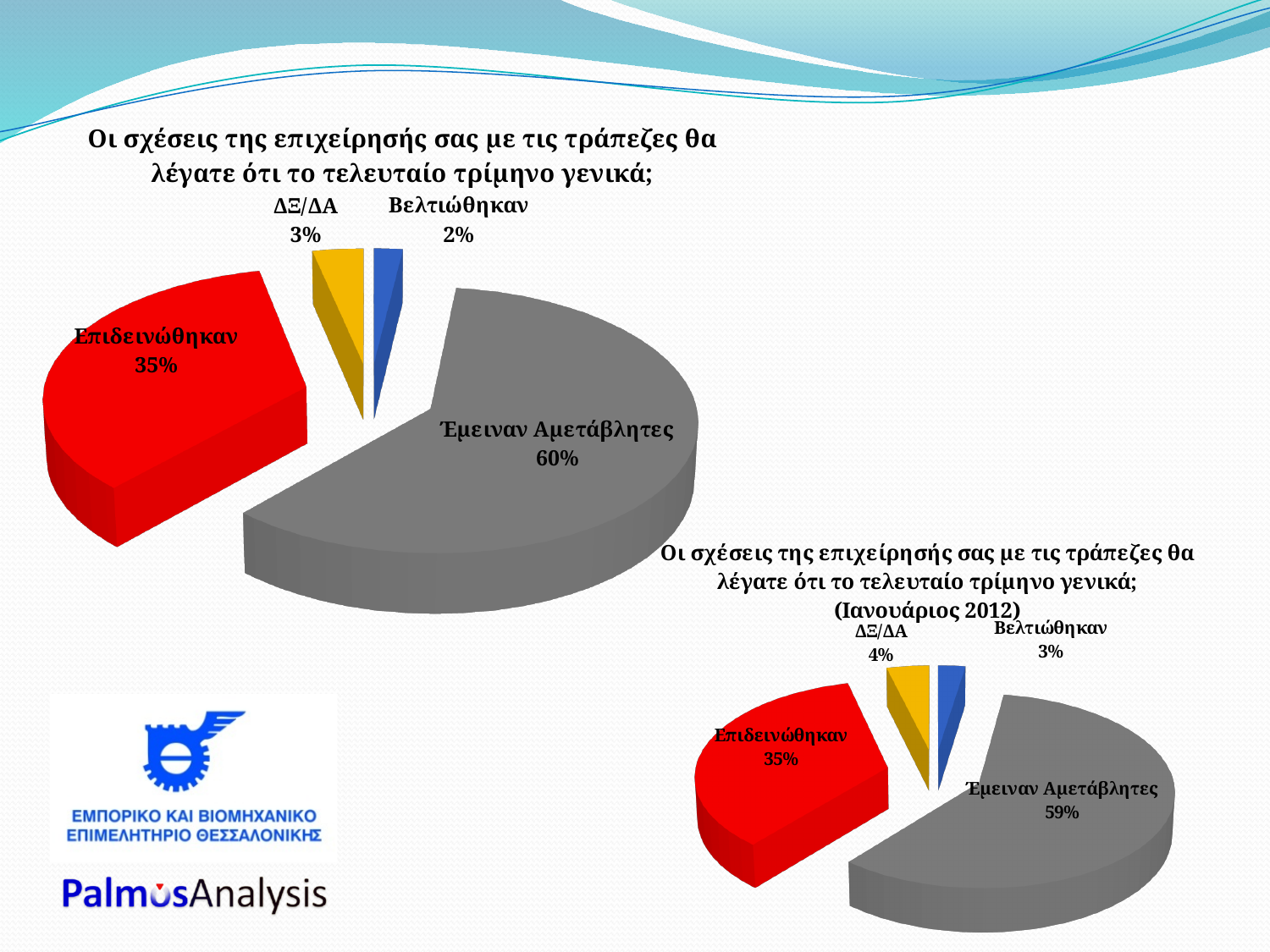
In the bottom-right pie chart (Ιανουάριος 2012), which category has the smallest share? Βελτιώθηκαν In the top-left pie chart, what percentage is shown for Βελτιώθηκαν? 2% In the bottom-right pie chart (Ιανουάριος 2012), which is larger: Επιδεινώθηκαν or ΔΞ/ΔΑ? Επιδεινώθηκαν In the top-left pie chart, what percentage is shown for Έμειναν Αμετάβλητες? 60% In the bottom-right pie chart (Ιανουάριος 2012), what percentage is shown for Έμειναν Αμετάβλητες? 59% In the top-left pie chart, which category has the largest share? Έμειναν Αμετάβλητες In the top-left pie chart, which category has the smallest share? Βελτιώθηκαν What type of chart is the bottom-right chart (Ιανουάριος 2012)? Pie chart In the top-left pie chart, what percentage is shown for Επιδεινώθηκαν? 35% How many slices does the top-left pie chart have? 4 In the bottom-right pie chart (Ιανουάριος 2012), what percentage is shown for ΔΞ/ΔΑ? 4% In the top-left pie chart, what is the difference in percentage points between Έμειναν Αμετάβλητες and Επιδεινώθηκαν? 25 percentage points